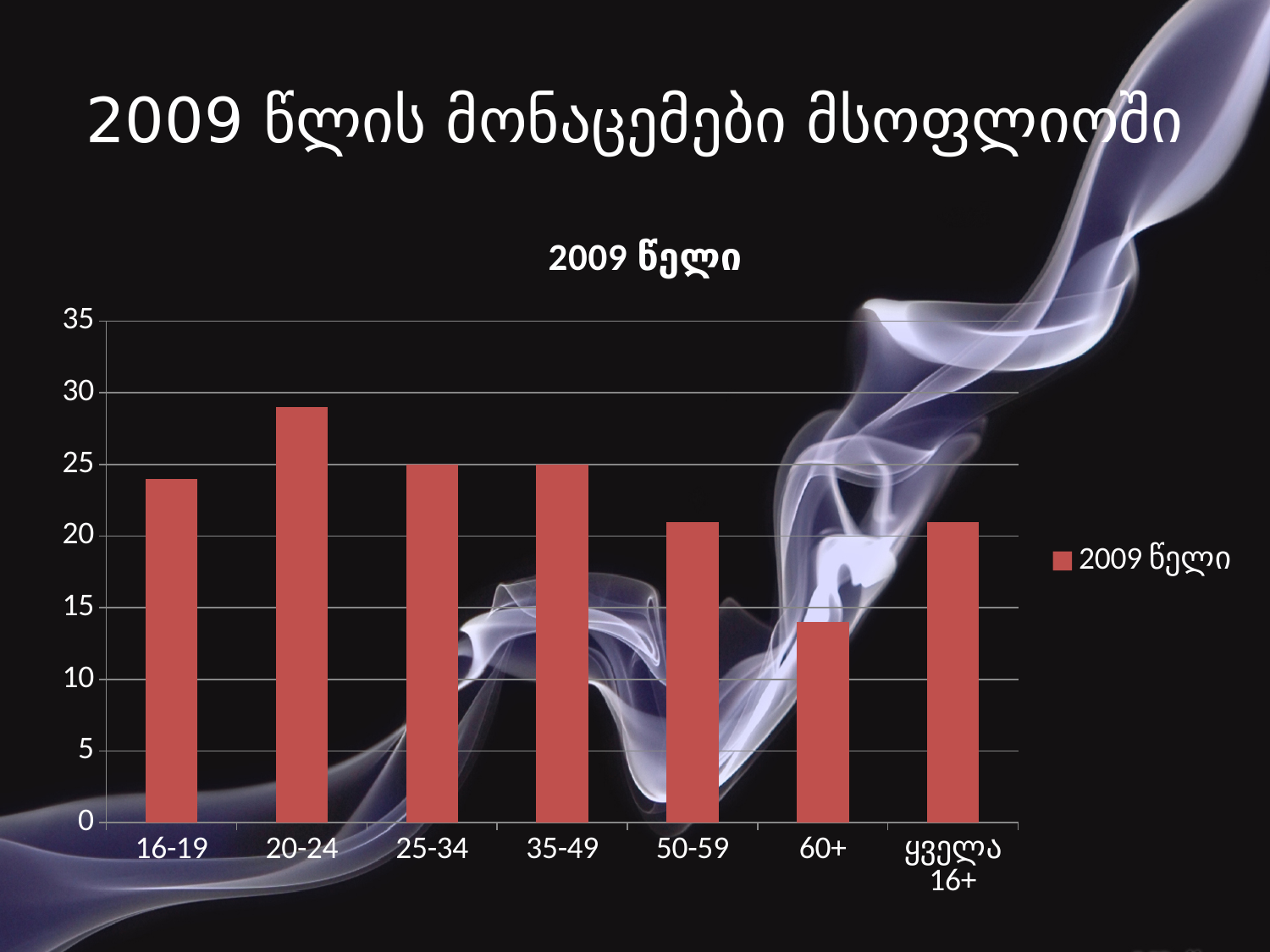
Which category has the lowest bar? 60+ What is the legend entry for the series in the chart? 2009 წელი What is the value for 35-49? 25 How many categories are shown on the x axis of the chart? 7 What is the value for 25-34? 25 How many series does the legend list? 1 What kind of chart is shown on the slide? bar chart Which category has the highest bar? 20-24 Is the value for 60+ greater or less than 20? less What is the title of the chart? 2009 წელი Is the value for 20-24 greater or less than 25? greater Which is larger, the value for 20-24 or the value for 60+? 20-24